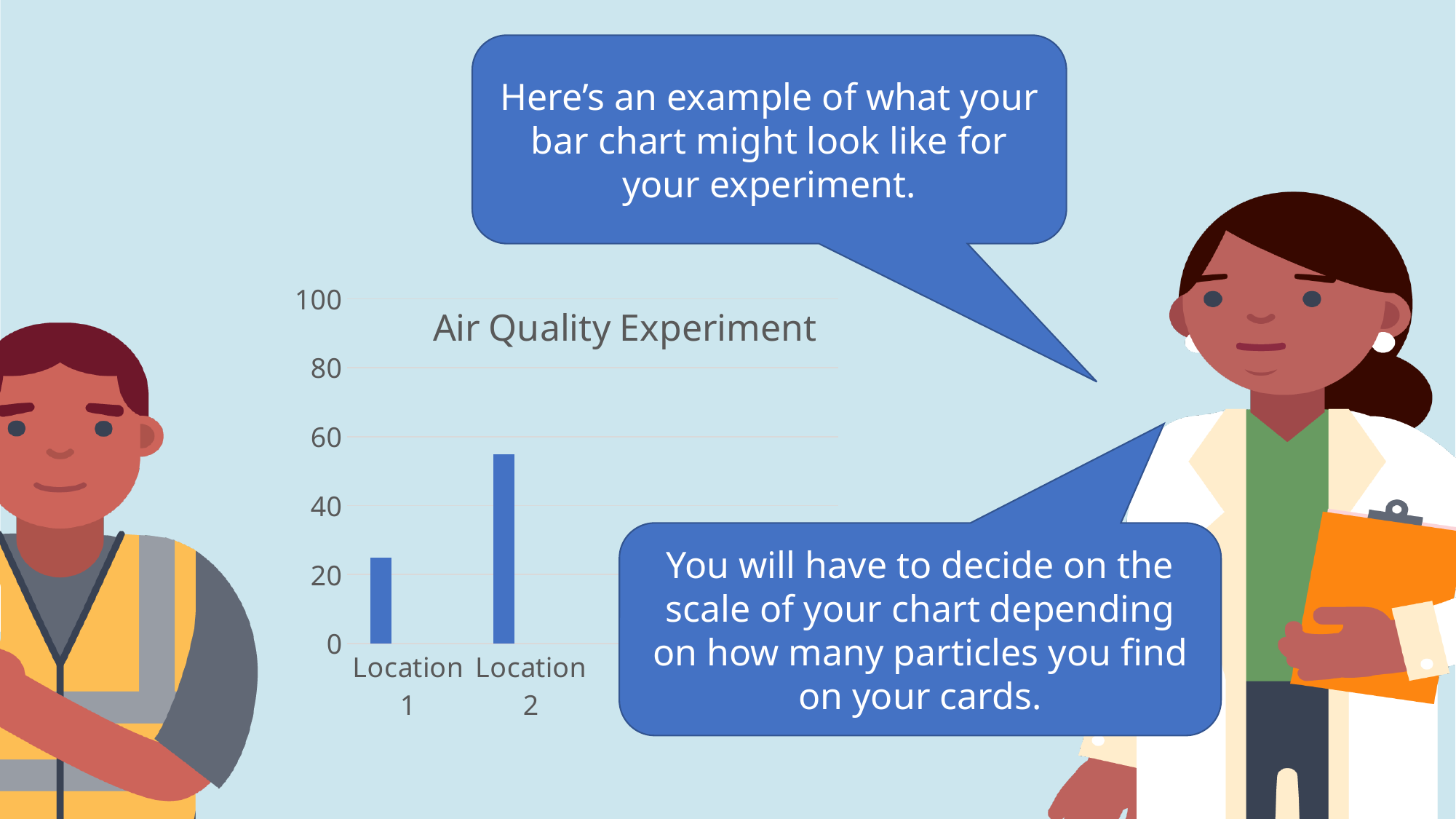
What is the highest value shown on the vertical axis of the chart? 100 Is the value for Location 1 greater or less than 40? less Which location has the lowest bar in the chart? Location 1 How many categories are plotted in the chart? 2 What is the title of the chart? Air Quality Experiment Do the values rise or fall from Location 1 to Location 2? rise Is the value for Location 1 greater or less than 20? greater Which location has the highest bar in the chart? Location 2 Is the value for Location 2 greater or less than 40? greater What kind of chart is shown on the slide? bar chart Which is larger, the value for Location 1 or the value for Location 2? Location 2